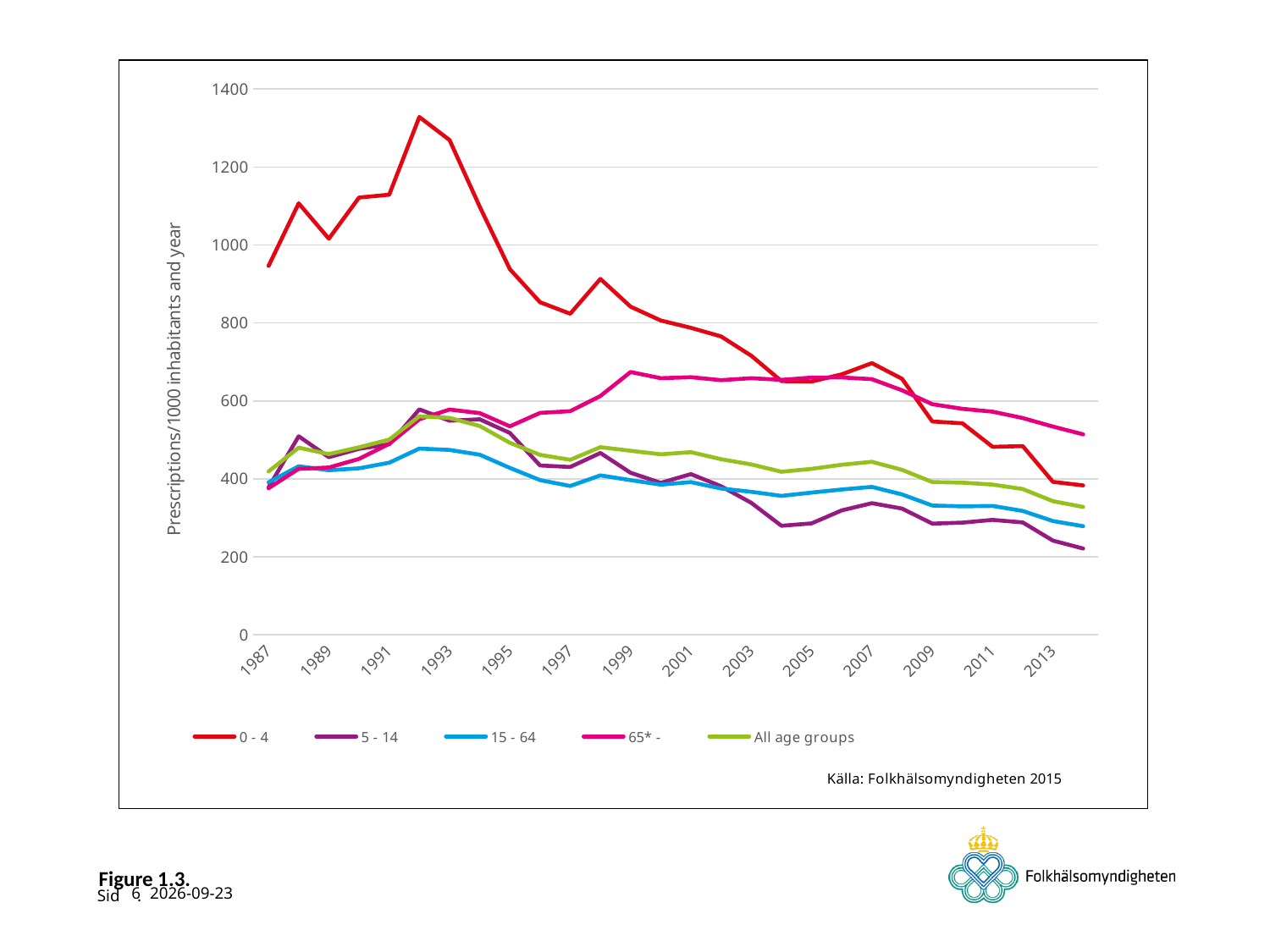
What kind of chart is shown on the slide? line chart Is the value for 15 - 64 in 1987 greater or less than 600? less In 1987, which series has the larger value, 0 - 4 or All age groups? 0 - 4 Does the 0 - 4 series rise or fall from 1993 to 2013? fall Is the value for 5 - 14 in 2013 greater or less than 400? less Which series has the lowest value in 2013? 5 - 14 Which series has the highest value in 1992? 0 - 4 Is the value for 65* - in 1999 greater or less than 600? greater In 2013, which series has the larger value, 0 - 4 or 65* -? 65* - What is the label on the y axis? Prescriptions/1000 inhabitants and year How many series does the legend list? 5